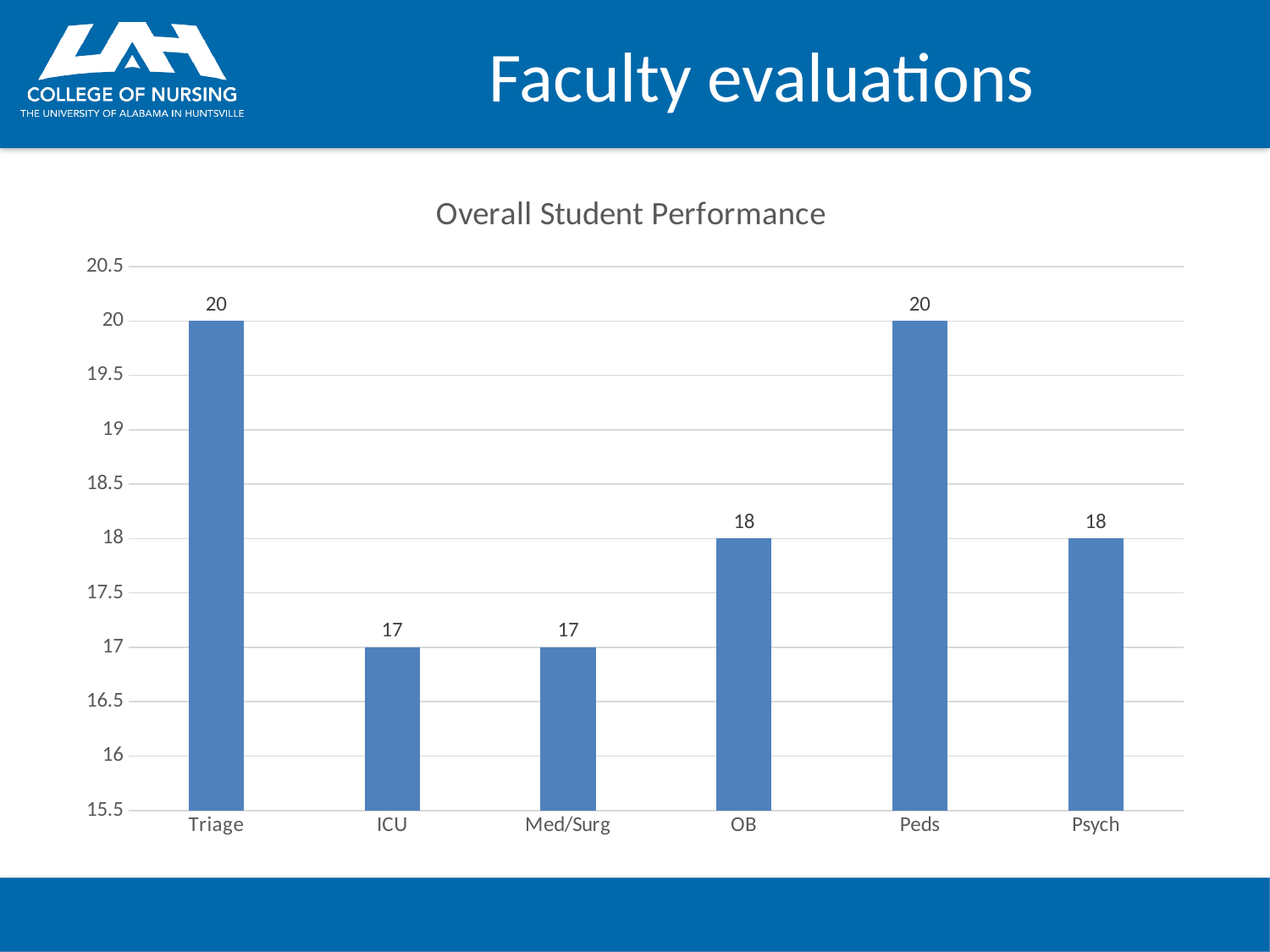
What is the difference between the values for Peds and Med/Surg? 3 Is the value for ICU greater or less than 18? less What is the value for Psych? 18 What kind of chart is shown on the slide? bar chart How many categories are shown on the x axis? 6 Which categories have the lowest value? ICU and Med/Surg What is the value for OB? 18 Which is larger, the value for Peds or the value for Psych? Peds What is the value for Triage? 20 What is the title of the chart? Overall Student Performance What is the difference between the values for Triage and OB? 2 What is the value for ICU? 17